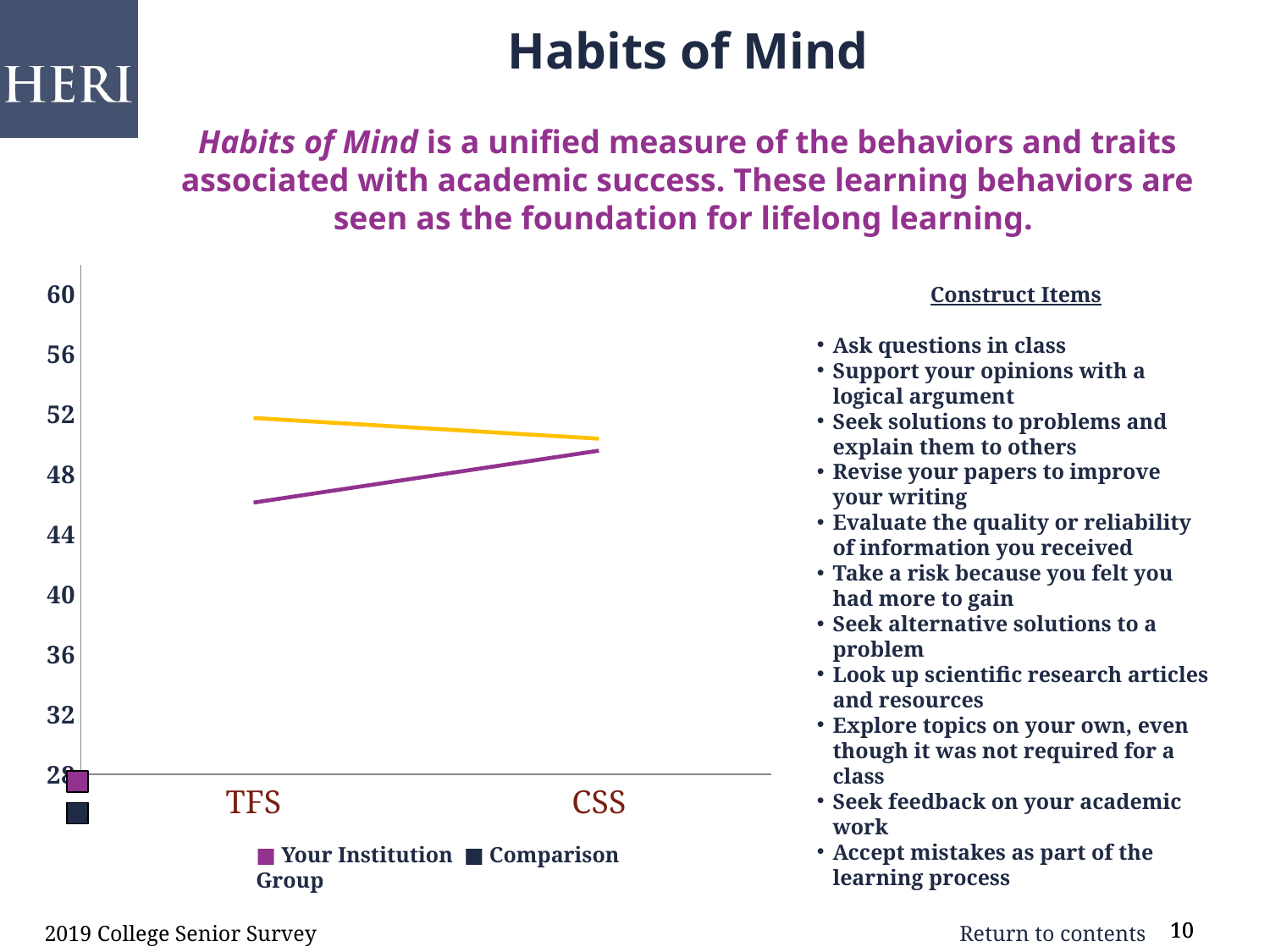
At TFS, which line is higher: the Your Institution line or the yellow line? the yellow line What kind of chart is shown on the slide? line chart Does the yellow line rise or fall from TFS to CSS? fall How many series does the chart legend list? 2 Is the Your Institution value at TFS greater or less than 48? less How many categories are shown on the x axis of the chart? 2 Is the Your Institution value at TFS greater or less than 44? greater Is the yellow line's value at CSS greater or less than 52? less What are the two categories on the x axis of the chart? TFS and CSS What is the highest value shown on the chart's vertical axis? 60 Does the Your Institution line rise or fall from TFS to CSS? rise